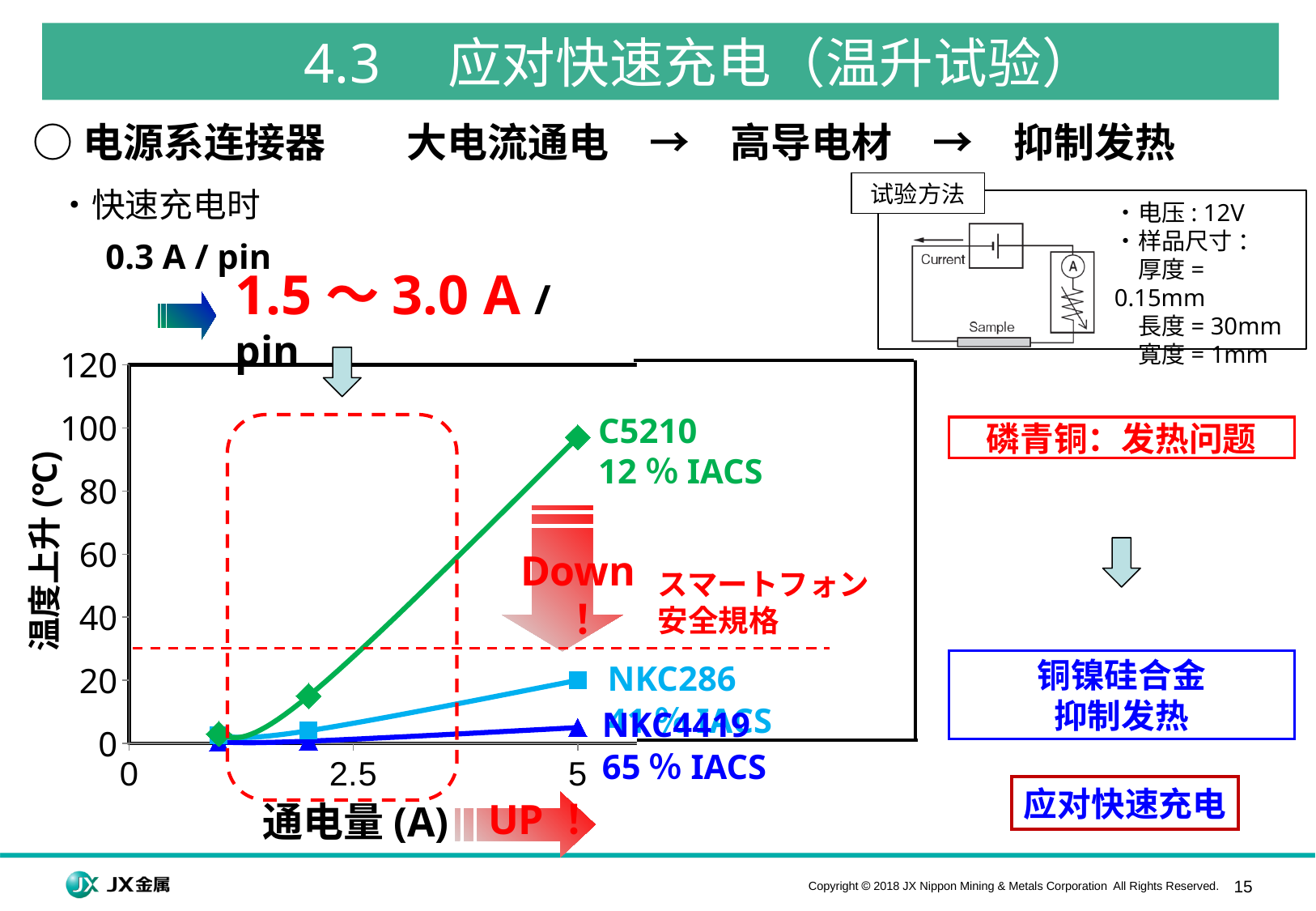
How many data points are plotted for the C5210 series? 3 How many material series are plotted in the chart? 3 Which material shows the highest temperature rise at 5 A? C5210 What colour is the line for C5210? green Is the temperature rise for NKC4419 at 5 A greater or less than 20? less How does the temperature rise for C5210 change as the current increases along the x axis? it rises What kind of chart is shown on the slide? line chart Which material shows the lowest temperature rise at 5 A? NKC4419 Is the temperature rise for C5210 at 5 A greater or less than 80? greater What is the label of the y axis of the chart? 温度上升 (℃) At 5 A, which has the larger temperature rise, C5210 or NKC286? C5210 Is the temperature rise for NKC286 at 5 A greater or less than 40? less